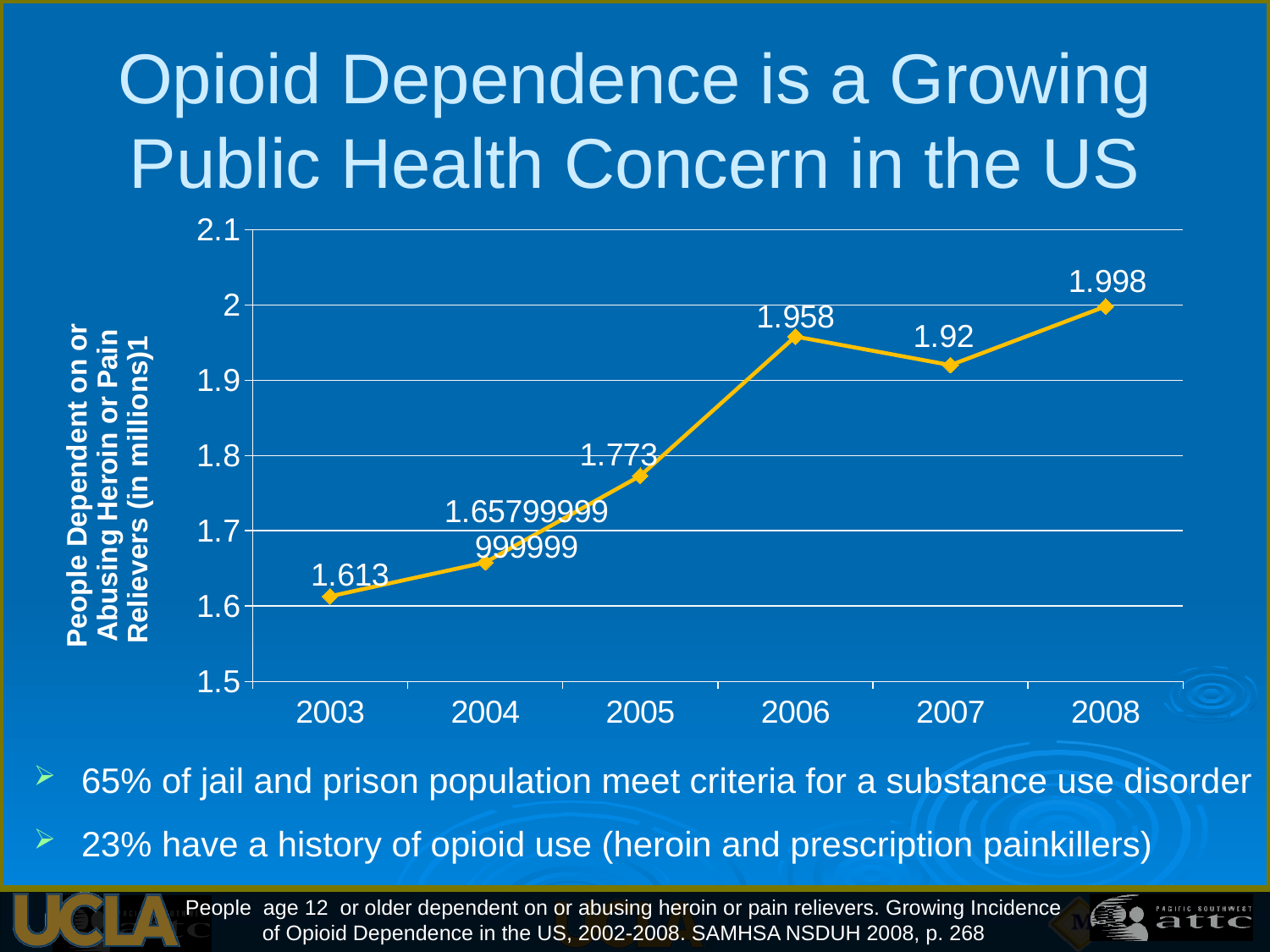
What is the difference between the values for 2008 and 2003? 0.385 Which year has the highest value? 2008 How many years are plotted on the x axis? 6 What is the value for 2008? 1.998 Is the value for 2004 greater or less than 1.7? less Which is larger, the value for 2006 or the value for 2007? 2006 What is the value for 2006? 1.958 Which year has the lowest value? 2003 What is the value for 2003? 1.613 What type of chart is shown on the slide? line chart What is the value for 2007? 1.92 What is the value for 2005? 1.773